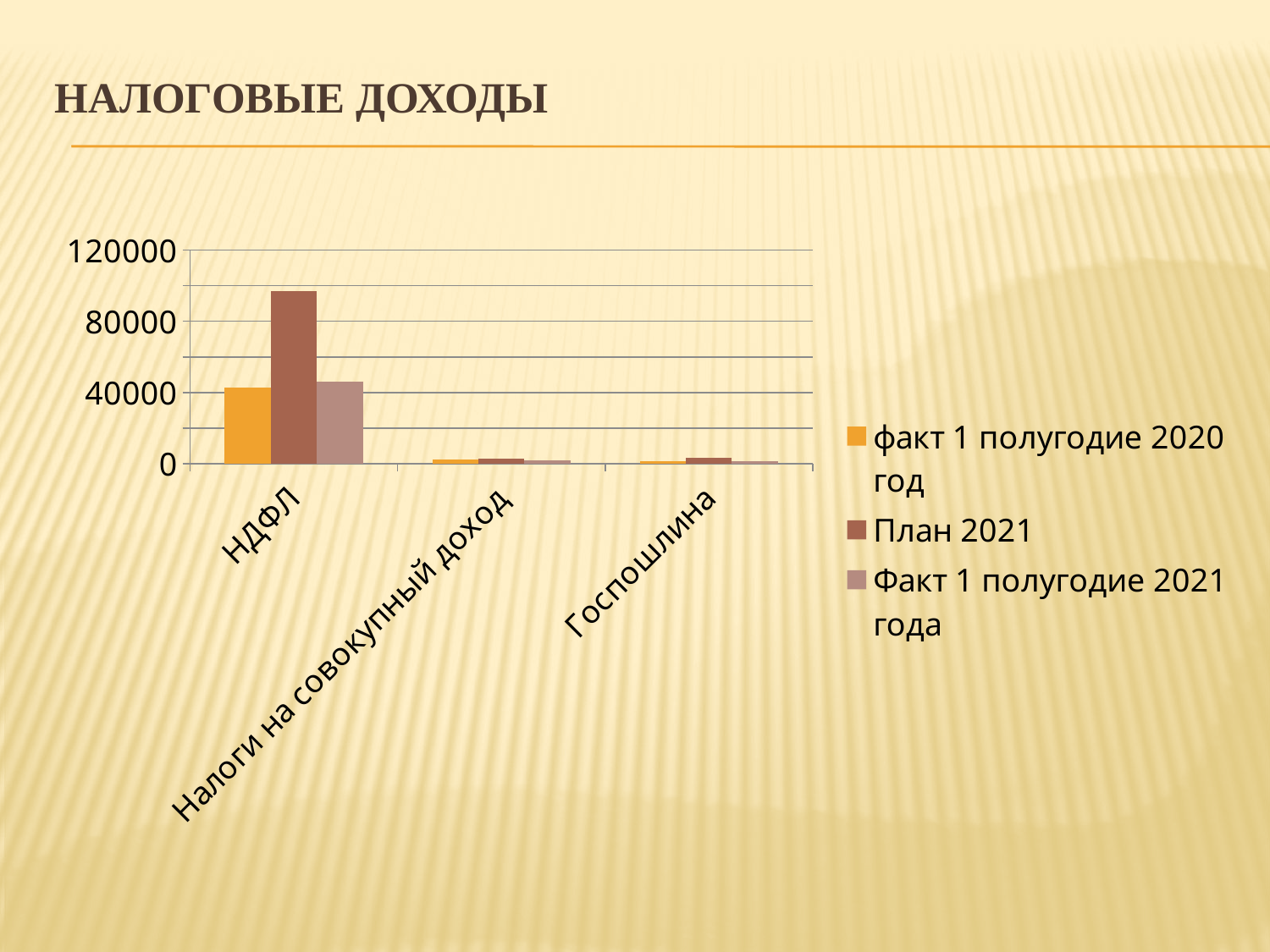
For НДФЛ, which is larger: План 2021 or факт 1 полугодие 2020 год? План 2021 Which series has the highest value for НДФЛ? План 2021 Which category has the highest values in the chart? НДФЛ What kind of chart is shown on the slide? bar chart Which is larger: the План 2021 value for НДФЛ or the План 2021 value for Госпошлина? НДФЛ Is the value of Факт 1 полугодие 2021 года for НДФЛ greater or less than 80000? less What is the highest value shown on the vertical axis? 120000 How many series does the legend list? 3 What is the title of the slide? НАЛОГОВЫЕ ДОХОДЫ How many categories are shown on the x axis of the chart? 3 Is the value of факт 1 полугодие 2020 год for НДФЛ greater or less than 80000? less Is the value of План 2021 for НДФЛ greater or less than 80000? greater